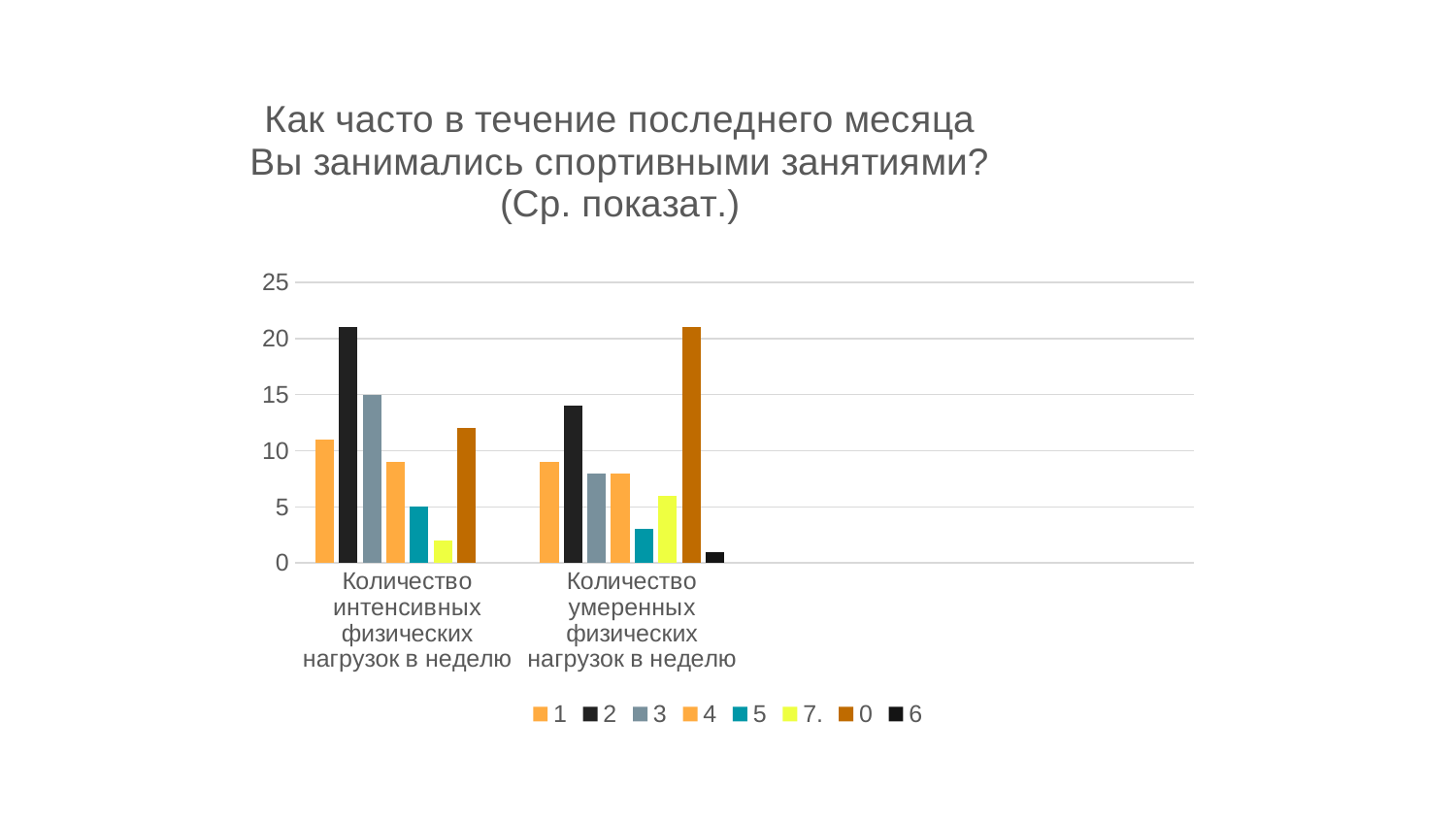
How many categories are shown on the x axis? 2 Is the value for series 2 in 'Количество интенсивных физических нагрузок в неделю' greater or less than 20? greater Is the value for series 0 in 'Количество умеренных физических нагрузок в неделю' greater or less than 20? greater In the category 'Количество умеренных физических нагрузок в неделю', which series has the lowest bar? 6 What is the title of the chart? Как часто в течение последнего месяца Вы занимались спортивными занятиями? (Ср. показат.) Which is larger: the value for series 0 in 'Количество интенсивных физических нагрузок в неделю' or in 'Количество умеренных физических нагрузок в неделю'? Количество умеренных физических нагрузок в неделю Which is larger: the value for series 2 in 'Количество интенсивных физических нагрузок в неделю' or in 'Количество умеренных физических нагрузок в неделю'? Количество интенсивных физических нагрузок в неделю How many series does the legend list? 8 In the category 'Количество интенсивных физических нагрузок в неделю', which series has the highest bar? 2 In the category 'Количество умеренных физических нагрузок в неделю', which series has the highest bar? 0 Is the value for series 7. in 'Количество интенсивных физических нагрузок в неделю' greater or less than 5? less What kind of chart is shown on the slide? bar chart